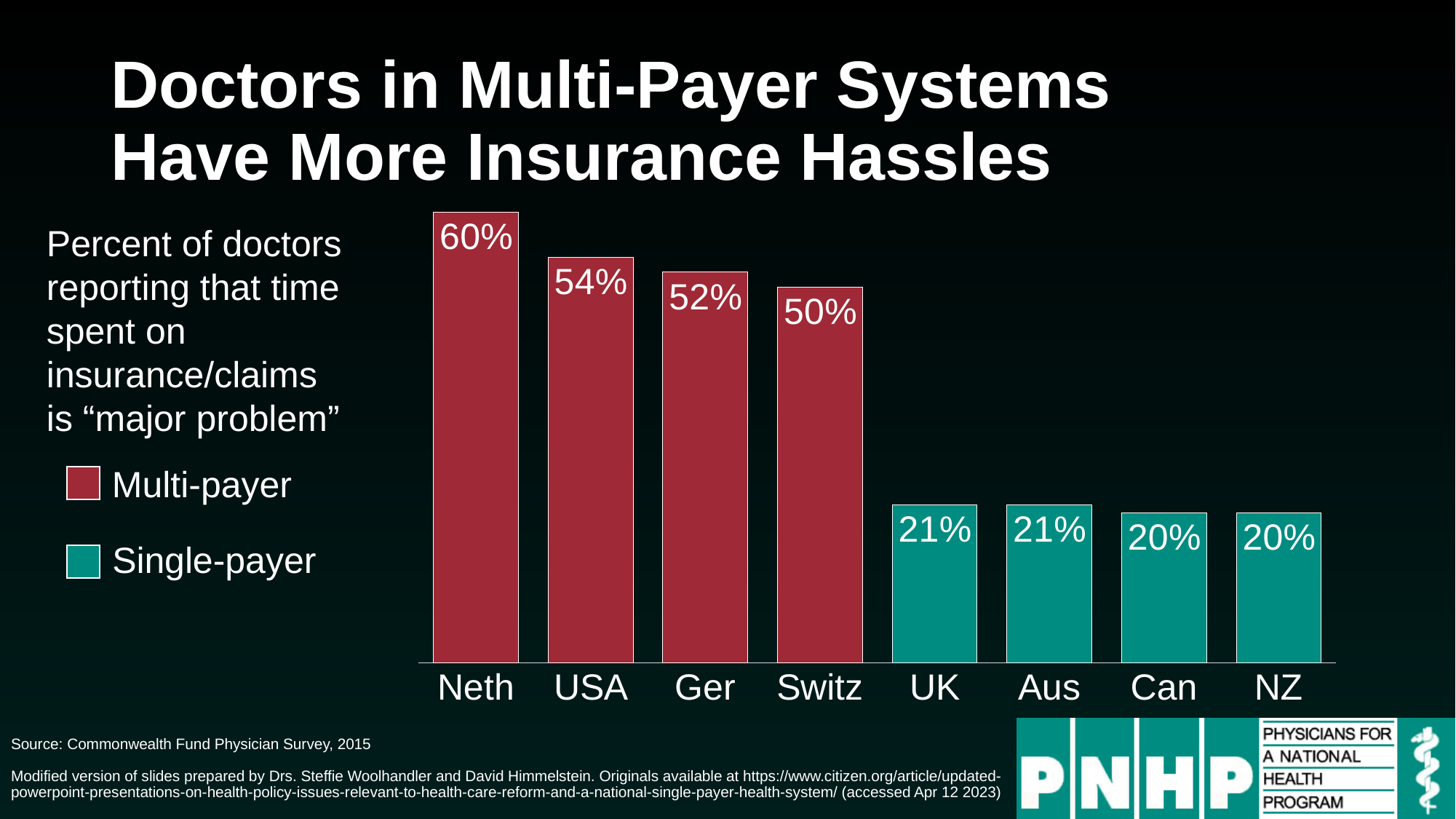
What is the difference between the values for USA and UK? 33% What is the difference between the values for Neth and Switz? 10% What is the value shown for Can? 20% Which countries are shown as single-payer (teal bars)? UK, Aus, Can, NZ How many series does the legend list? 2 Which legend entry is shown in red? Multi-payer What is the value shown for the USA? 54% Which is larger, the value for Ger or the value for Aus? Ger What kind of chart is shown on the slide? Bar chart Which country has the highest percentage of doctors reporting insurance/claims time as a major problem? Neth How many countries are shown on the chart? 8 What percent of doctors in the Netherlands (Neth) report that time spent on insurance/claims is a major problem? 60%